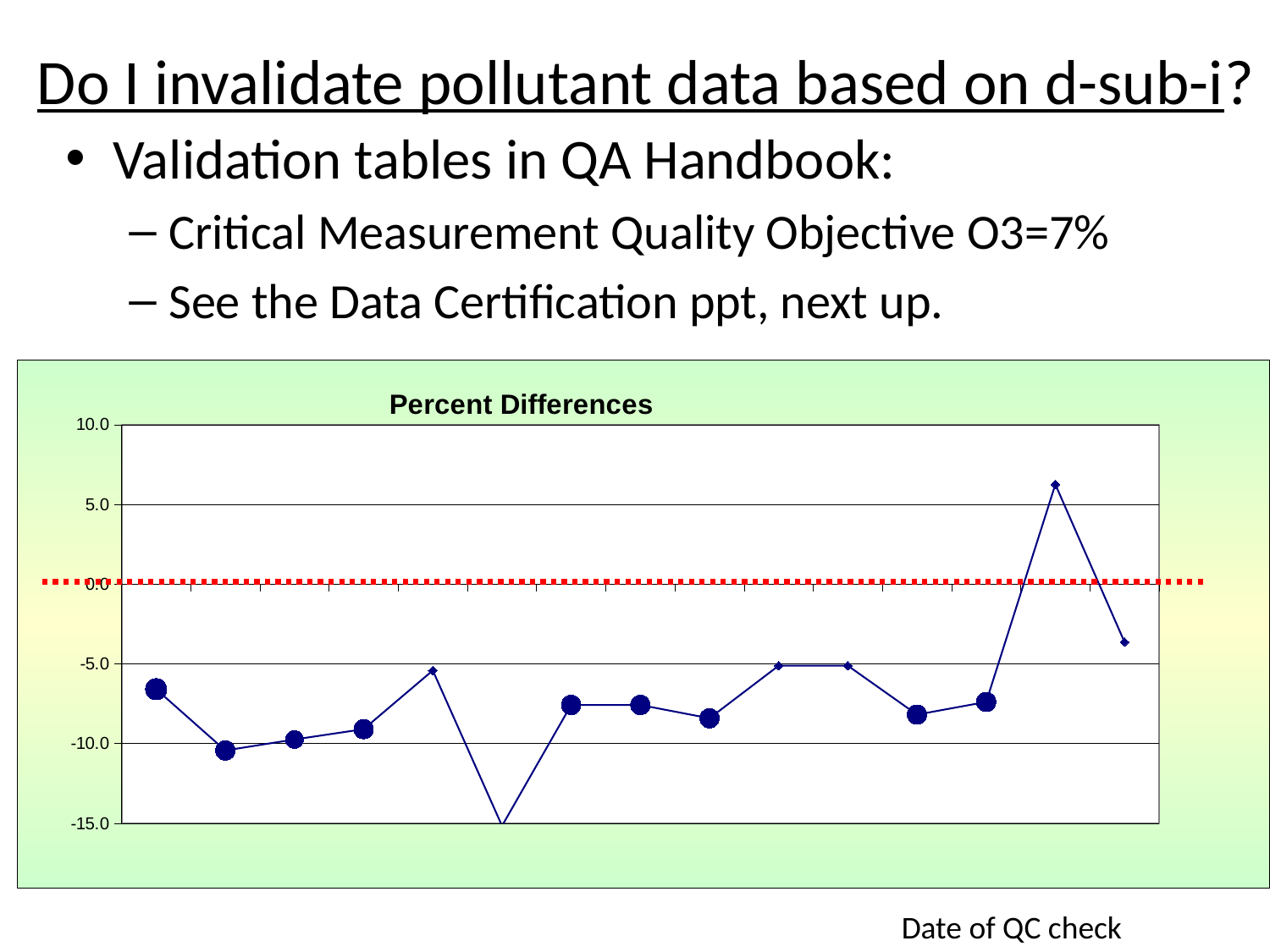
Is the lowest point on the line greater or less than -10.0? less How many data points are plotted on the line? 15 Is the last point on the line greater or less than 0.0? less What colour is the dashed horizontal reference line at 0.0? red What kind of chart is shown on the slide? line chart Is the last point on the line greater or less than -5.0? greater How many data points lie above 0.0? 1 What is the highest value shown on the y axis? 10.0 What is the title of the chart? Percent Differences Which is larger, the first point or the second point on the line? the first point